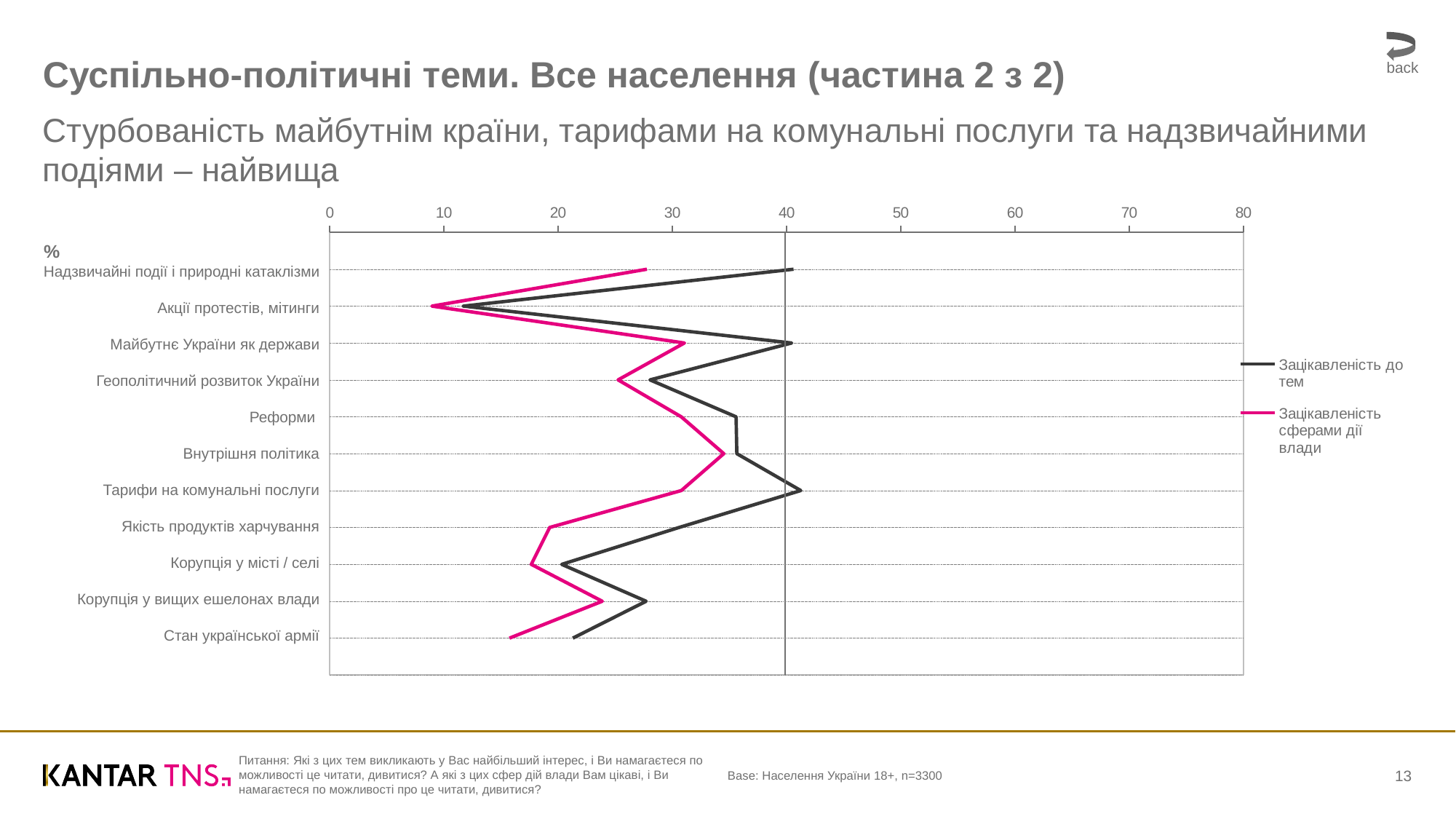
For 'Надзвичайні події і природні катаклізми', which series has the larger value: 'Зацікавленість до тем' or 'Зацікавленість сферами дії влади'? Зацікавленість до тем Is the value for 'Корупція у вищих ешелонах влади' in the series 'Зацікавленість до тем' greater or less than 30? less Is the value for 'Акції протестів, мітинги' in the series 'Зацікавленість до тем' greater or less than 20? less For 'Стан української армії', which series has the larger value: 'Зацікавленість до тем' or 'Зацікавленість сферами дії влади'? Зацікавленість до тем Is the value for 'Надзвичайні події і природні катаклізми' in the series 'Зацікавленість сферами дії влади' greater or less than 30? less How many series does the legend list? 2 What kind of chart is shown on the slide? line chart How many topics (categories) are plotted on the chart? 11 What colour is the line for the series 'Зацікавленість сферами дії влади'? pink Which topic has the lowest value for the series 'Зацікавленість сферами дії влади'? Акції протестів, мітинги Which topic has the lowest value for the series 'Зацікавленість до тем'? Акції протестів, мітинги